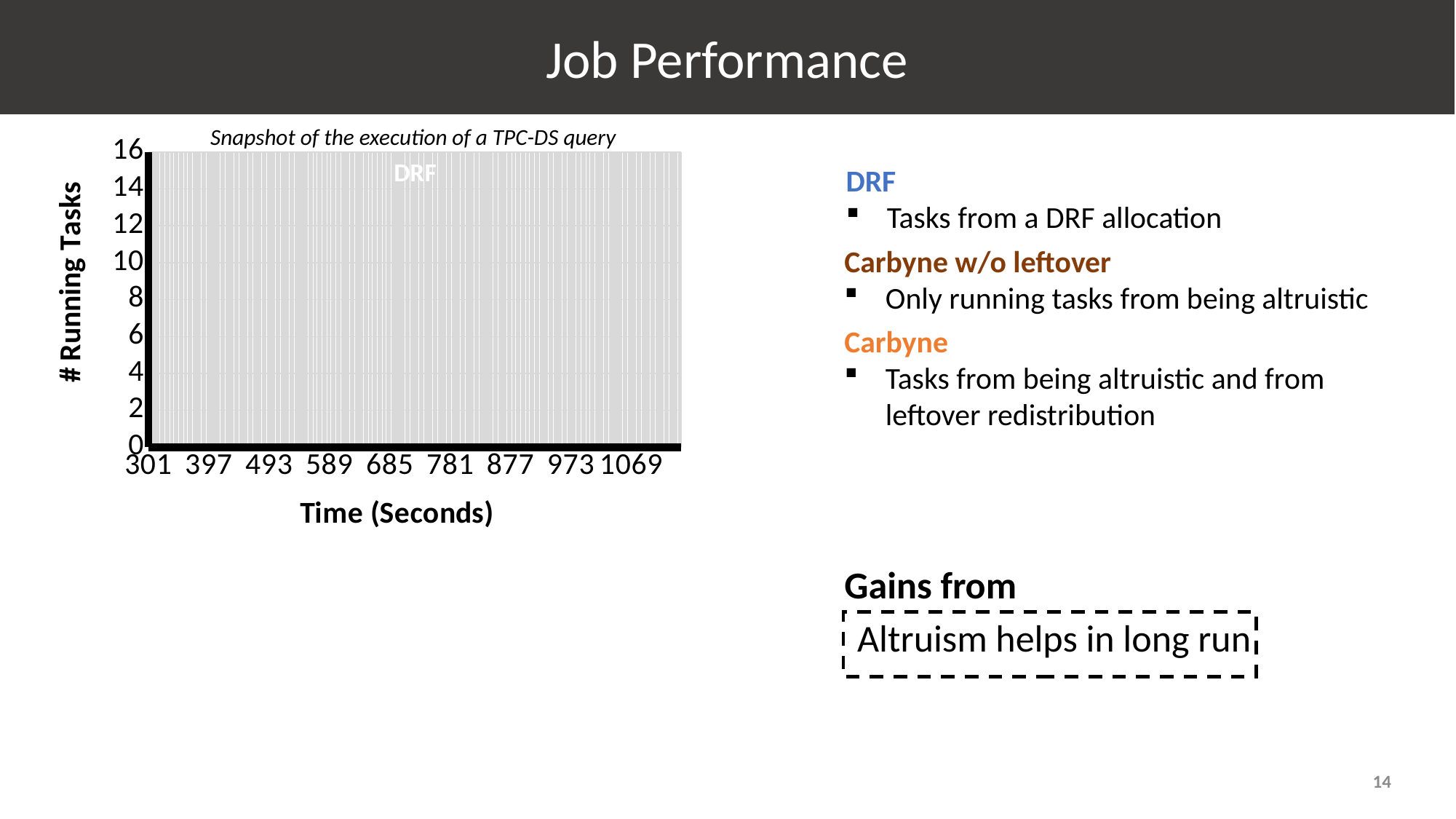
What is the highest value shown on the y axis of the chart? 16 What is the last time value labelled on the x axis of the chart? 1069 What is the label of the y axis of the chart? # Running Tasks What is the first time value shown on the x axis of the chart? 301 Which series is labelled inside the plot area of the chart? DRF What is the title shown above the chart? Snapshot of the execution of a TPC-DS query